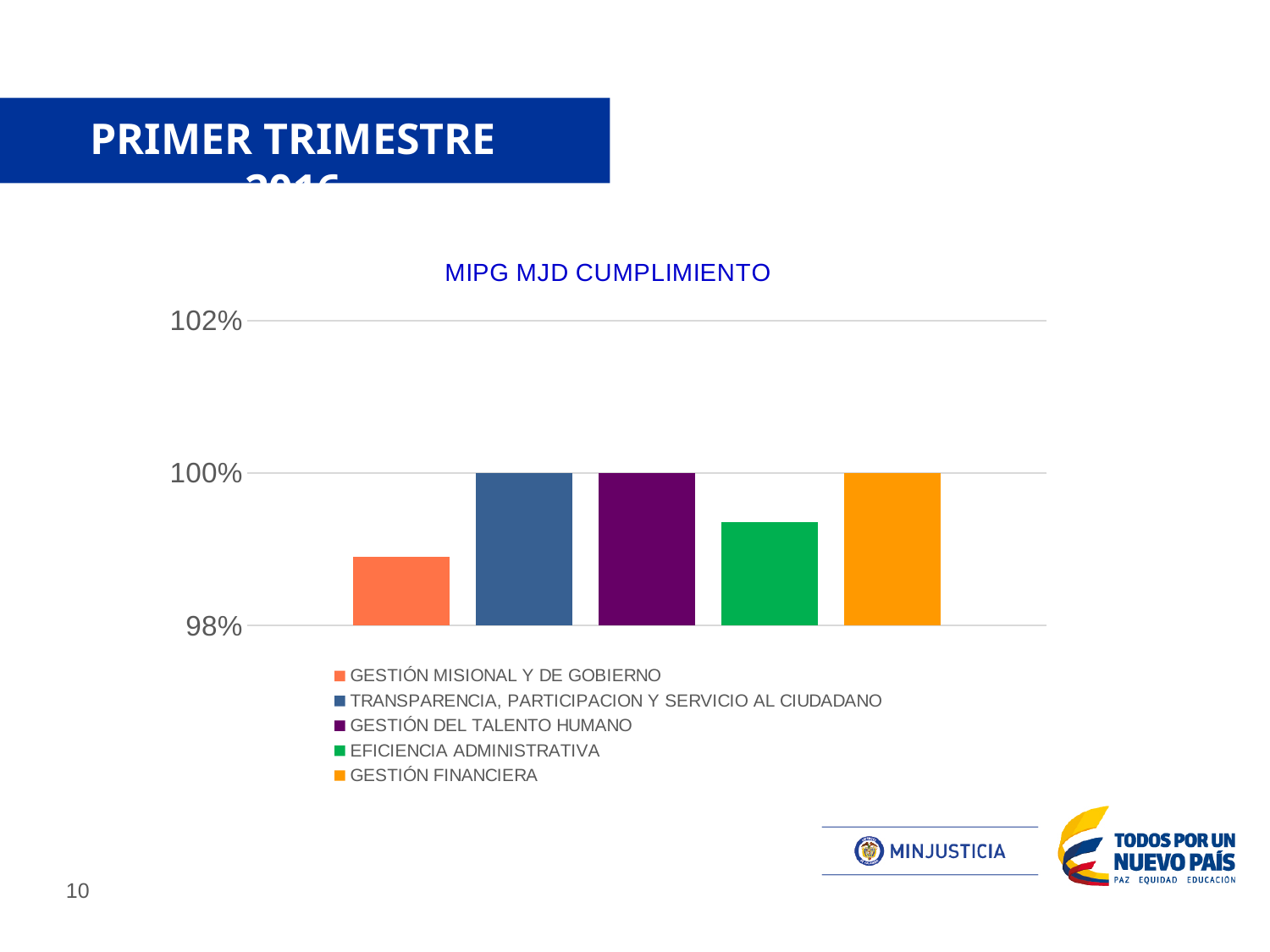
What is the value for GESTIÓN FINANCIERA? 100% Which category has the lowest value in the chart? GESTIÓN MISIONAL Y DE GOBIERNO Is the value for EFICIENCIA ADMINISTRATIVA greater or less than 100%? less How many entries does the chart's legend list? 5 Which is larger, the value for EFICIENCIA ADMINISTRATIVA or the value for GESTIÓN MISIONAL Y DE GOBIERNO? EFICIENCIA ADMINISTRATIVA How many bars (categories) are plotted in the chart? 5 What kind of chart is shown on the slide? bar chart What colour is the bar for GESTIÓN DEL TALENTO HUMANO? purple Is the value for GESTIÓN MISIONAL Y DE GOBIERNO greater or less than 100%? less What is the title of the chart? MIPG MJD CUMPLIMIENTO What is the value for GESTIÓN DEL TALENTO HUMANO? 100% What is the value for TRANSPARENCIA, PARTICIPACION Y SERVICIO AL CIUDADANO? 100%